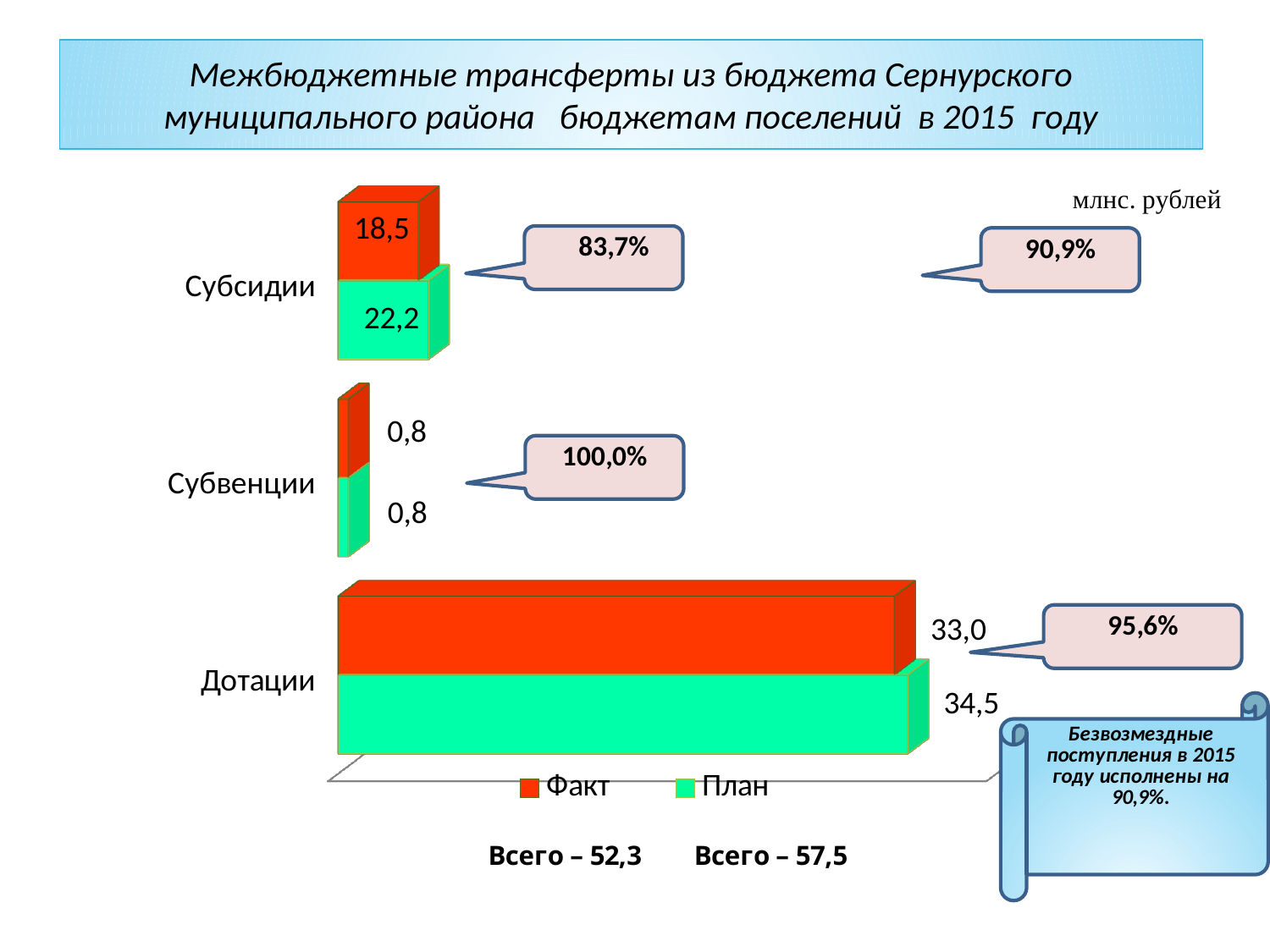
What is the План value for Дотации? 34,5 What is the difference between the План and Факт values for Дотации? 1,5 What is the Факт value for Дотации? 33,0 How many series does the legend list? 2 How many categories are shown in the chart? 3 What is the Факт value for Субвенции? 0,8 Which category has the lowest План value? Субвенции Which category has the highest Факт value? Дотации What is the План value for Субсидии? 22,2 Which is larger for Субсидии, the Факт value or the План value? План What is the difference between the План and Факт values for Субсидии? 3,7 What is the Факт value for Субсидии? 18,5